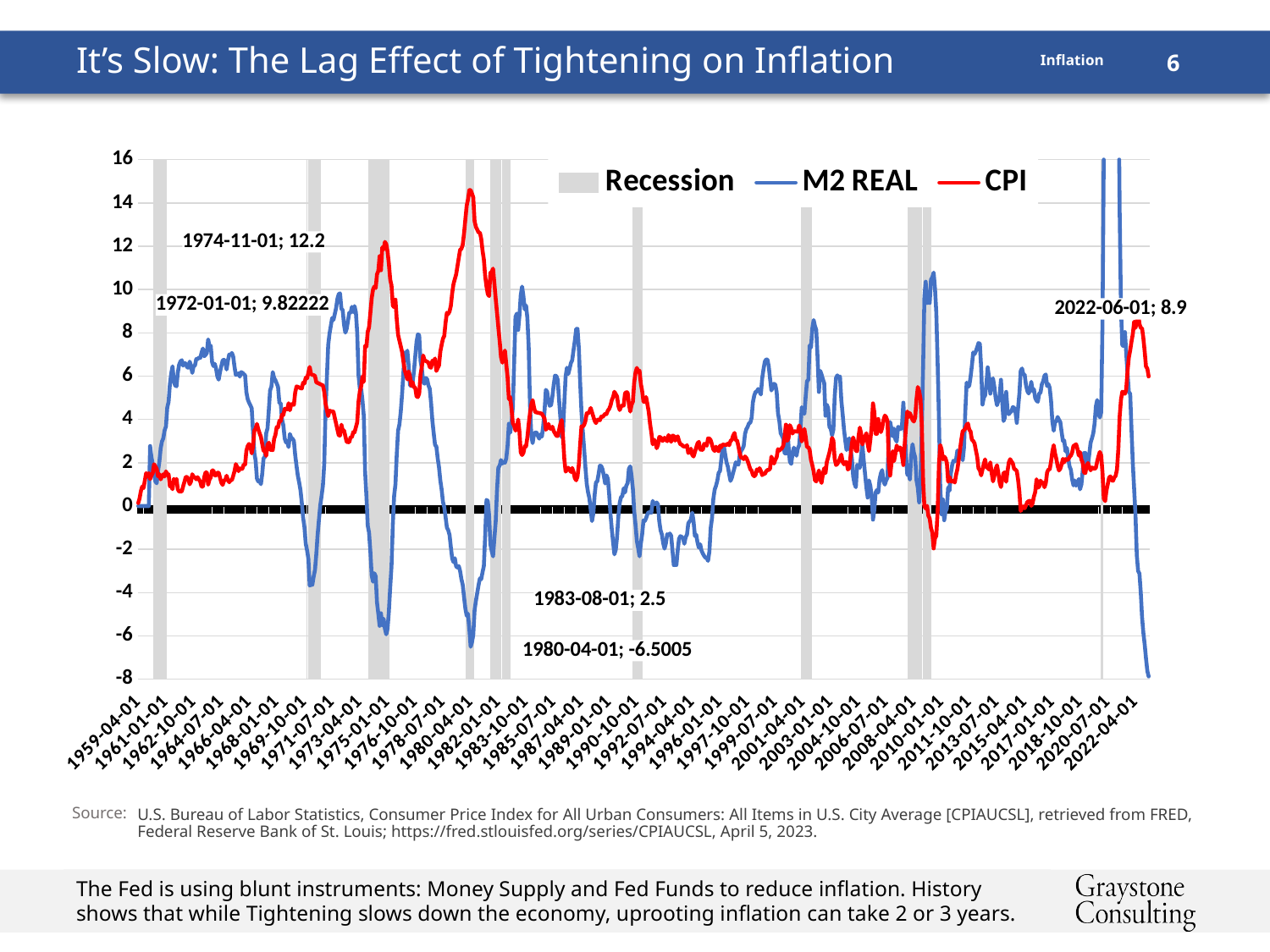
What value is labeled on the chart at 2022-06-01? 8.9 Which labeled value is larger: the one at 1974-11-01 or the one at 2022-06-01? 1974-11-01 Is the labeled value at 2022-06-01 greater or less than 8? greater What is the difference between the labeled value at 1974-11-01 and the labeled value at 2022-06-01? 3.3 What colour is the CPI line in the chart? red What value is labeled on the chart at 1983-08-01? 2.5 What value is labeled on the chart at 1980-04-01? -6.5005 How many entries does the chart legend list? 3 What kind of chart is shown on the slide? line chart Which legend entry is represented by the grey shaded bands in the chart? Recession What value is labeled on the chart at 1974-11-01? 12.2 What value is labeled on the chart at 1972-01-01? 9.82222